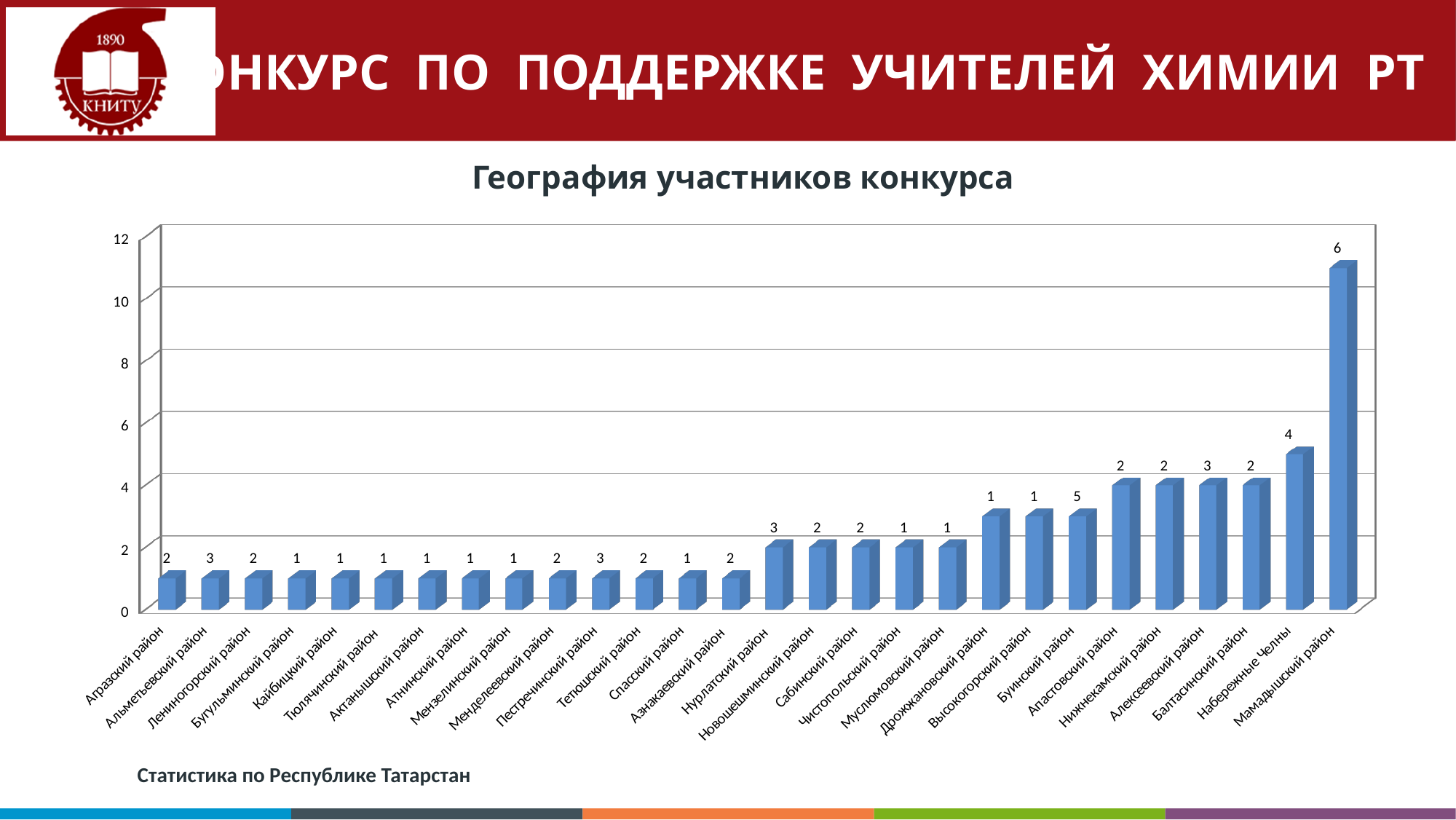
What is the data label shown for Набережные Челны? 4 What kind of chart is shown on the slide? bar chart What is the data label shown for Альметьевский район? 3 What is the title of the chart? География участников конкурса Which district has the highest value in the chart? Мамадышский район What is the data label shown for Бугульминский район? 1 What is the highest value shown on the vertical axis of the chart? 12 What is the data label shown for Буинский район? 5 Which is larger, the value for Мамадышский район or the value for Набережные Челны? Мамадышский район How many districts (categories) are shown on the x axis of the chart? 28 What is the data label shown for Мамадышский район? 6 What is the data label shown for Нурлатский район? 3